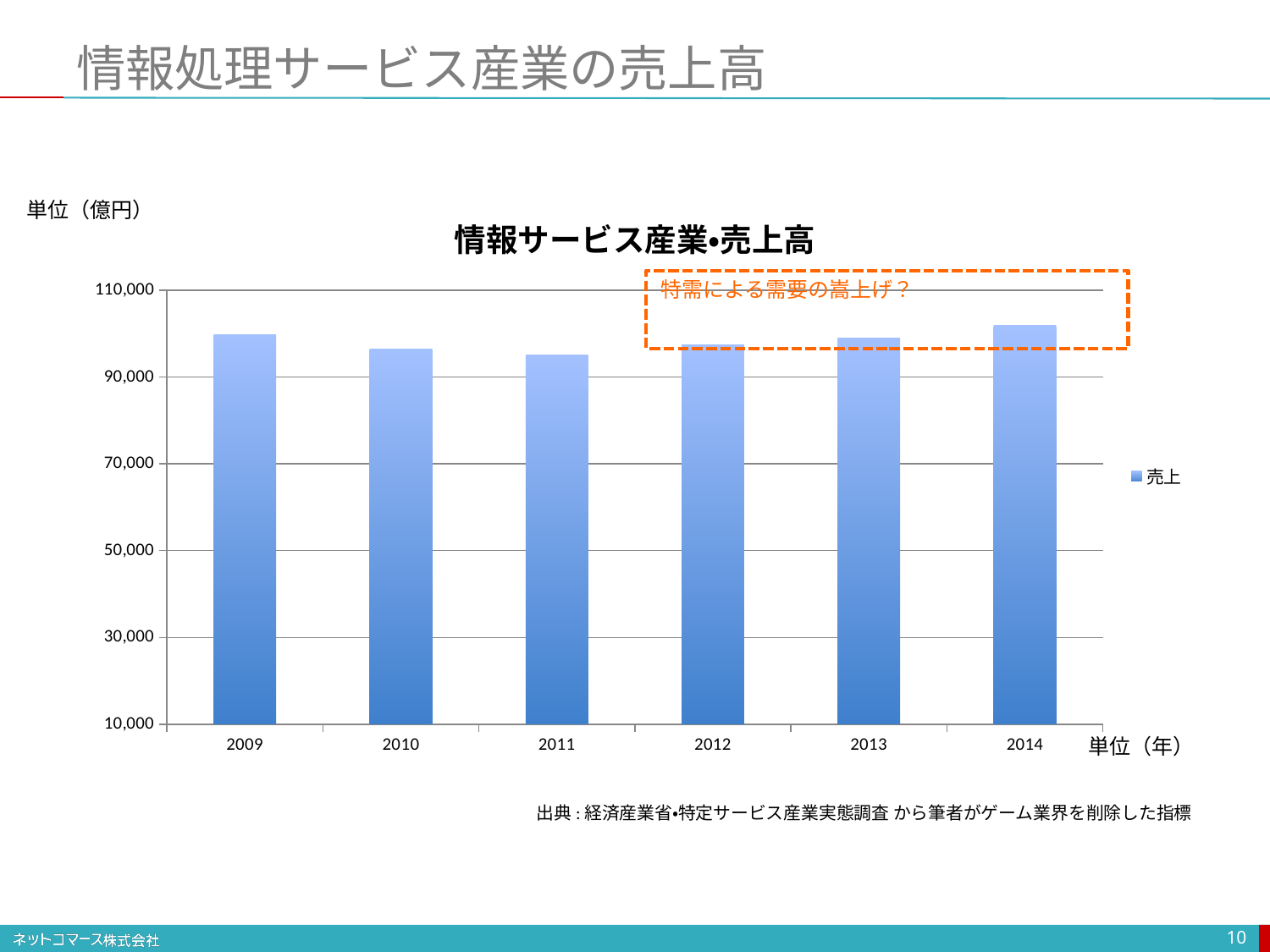
Is the value for 2014 greater or less than 90,000? greater How many series does the chart legend list? 1 Do the values rise or fall from 2011 to 2014? rise Which year has the highest bar in the chart? 2014 Which is larger, the value for 2009 or the value for 2011? 2009 What is the title of the chart? 情報サービス産業•売上高 Is the value for 2011 greater or less than 110,000? less What is the name of the series shown in the chart legend? 売上 Is the value for 2009 greater or less than 90,000? greater Which is larger, the value for 2014 or the value for 2012? 2014 How many years are plotted on the x axis of the chart? 6 What kind of chart is shown on the slide? bar chart